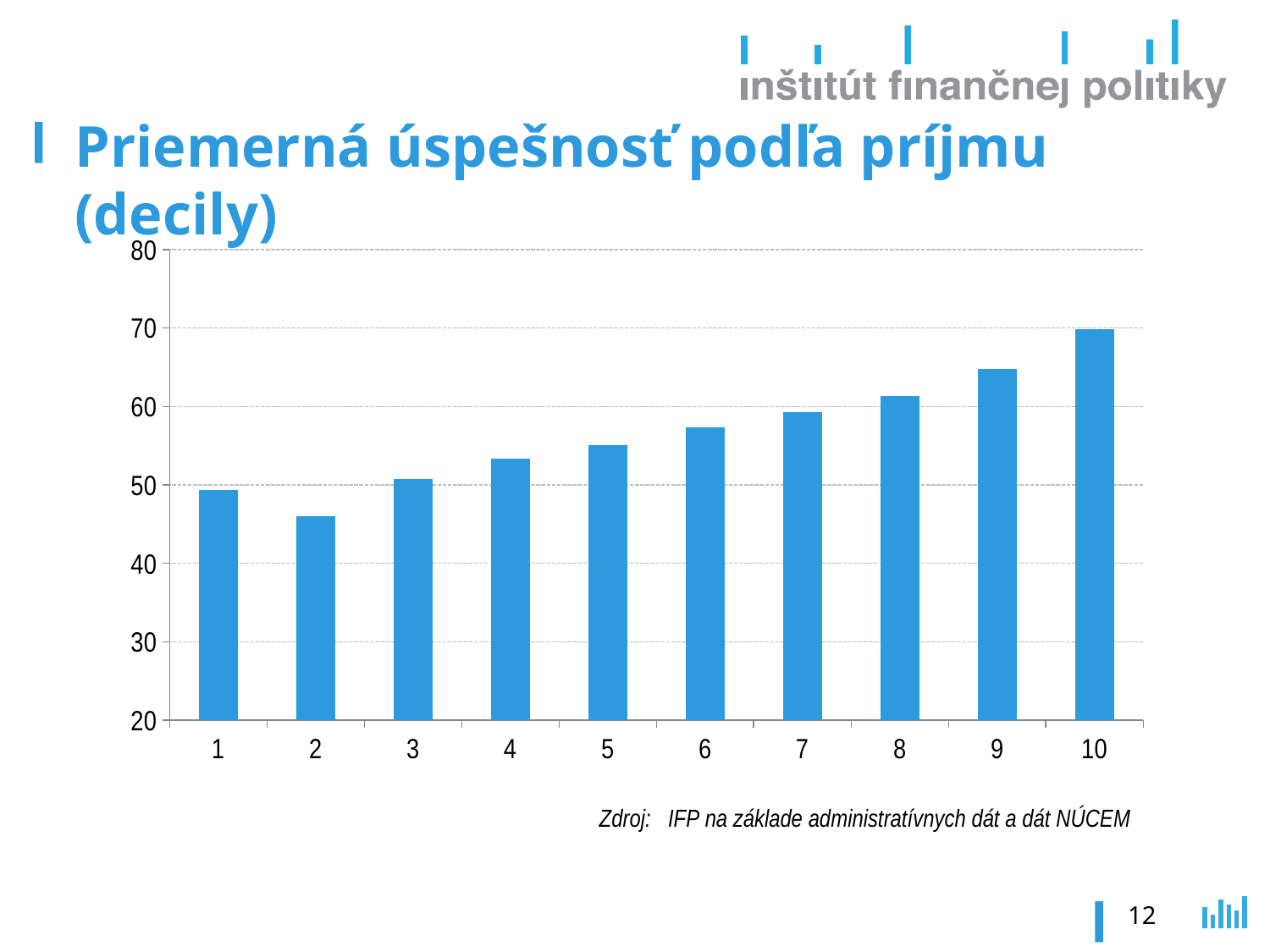
What is the title of the chart on the slide? Priemerná úspešnosť podľa príjmu (decily) Is the value for decile 8 greater or less than 60? greater Is the value for decile 10 greater or less than 60? greater What kind of chart is shown on the slide? bar chart Which decile has the highest bar? 10 From decile 2 to decile 10, do the values rise or fall? rise Is the value for decile 4 greater or less than 60? less How many deciles (categories) are plotted on the x axis? 10 Which is larger, the value for decile 9 or the value for decile 7? decile 9 Which is larger, the value for decile 1 or the value for decile 2? decile 1 Which decile has the lowest bar? 2